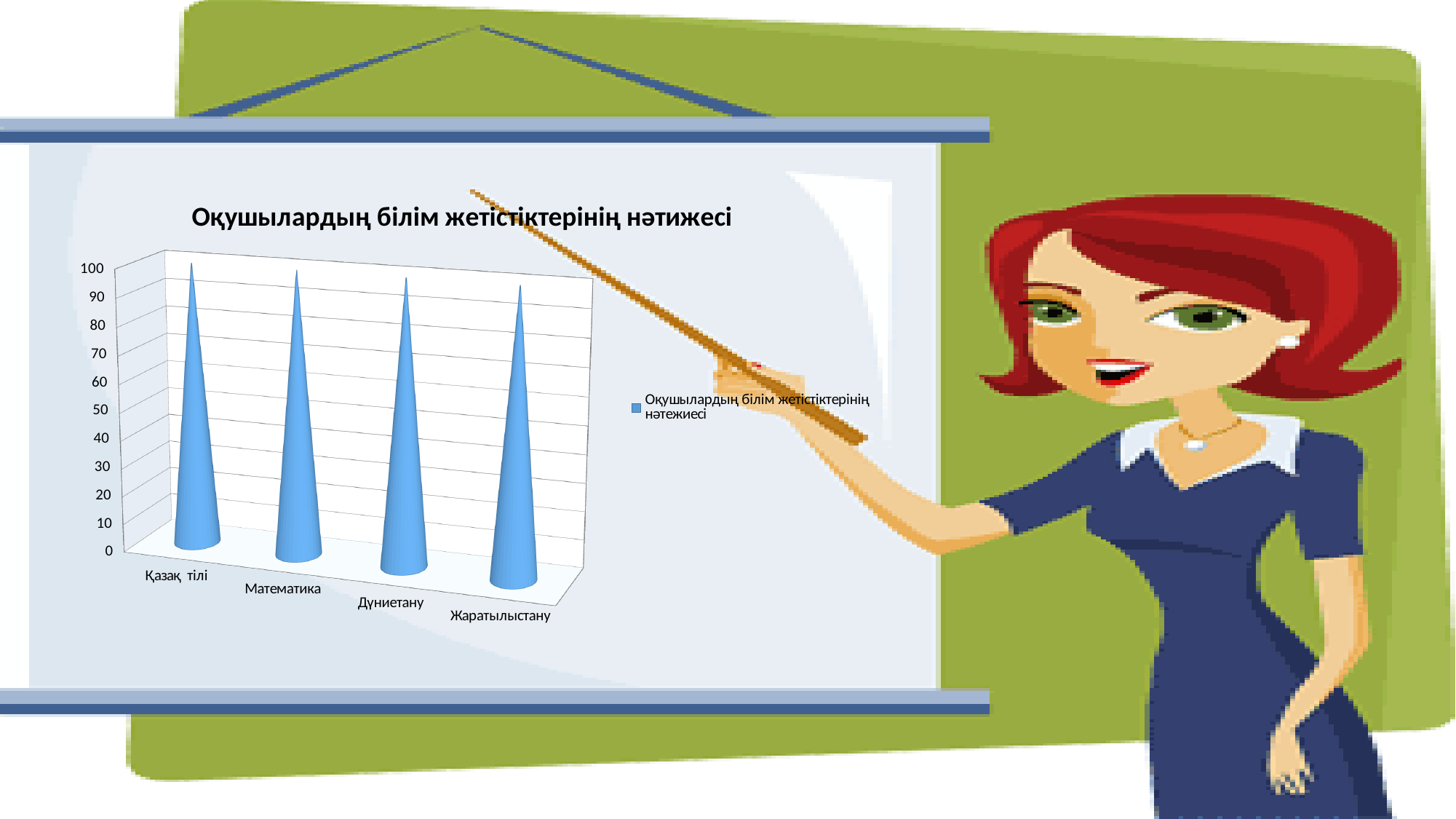
Is the value for Математика greater or less than 50? greater Is the value for Дүниетану greater or less than 50? greater Is the value for Қазақ тілі greater or less than 50? greater What is the highest value shown on the chart's vertical axis? 100 How many series does the chart's legend list? 1 What is the title of the chart? Оқушылардың білім жетістіктерінің нәтижесі What kind of chart is shown on the slide? bar chart What is the legend entry shown for the chart's series? Оқушылардың білім жетістіктерінің нәтежиесі How many categories are shown on the x axis of the chart? 4